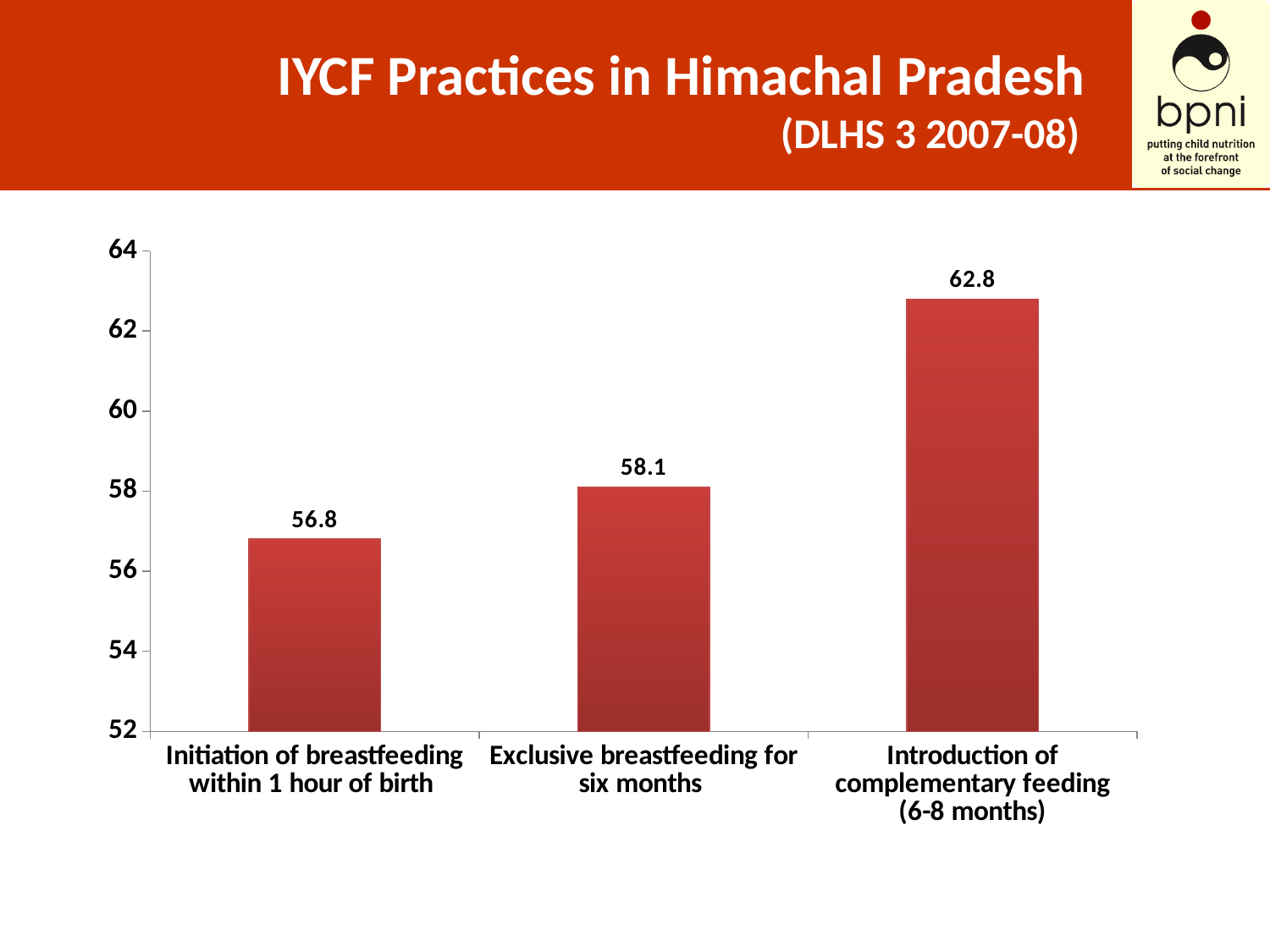
What is the difference between the values for Introduction of complementary feeding (6-8 months) and Initiation of breastfeeding within 1 hour of birth? 6 What is the title of the slide? IYCF Practices in Himachal Pradesh (DLHS 3 2007-08) What is the difference between the values for Exclusive breastfeeding for six months and Initiation of breastfeeding within 1 hour of birth? 1.3 What is the value for Initiation of breastfeeding within 1 hour of birth? 56.8 What is the value for Exclusive breastfeeding for six months? 58.1 What kind of chart is shown on the slide? bar chart Is the value for Introduction of complementary feeding (6-8 months) greater or less than 60? greater How many categories are shown in the chart? 3 Which category has the highest value? Introduction of complementary feeding (6-8 months) What is the value for Introduction of complementary feeding (6-8 months)? 62.8 Which category has the lowest value? Initiation of breastfeeding within 1 hour of birth Which is larger: the value for Exclusive breastfeeding for six months or the value for Initiation of breastfeeding within 1 hour of birth? Exclusive breastfeeding for six months